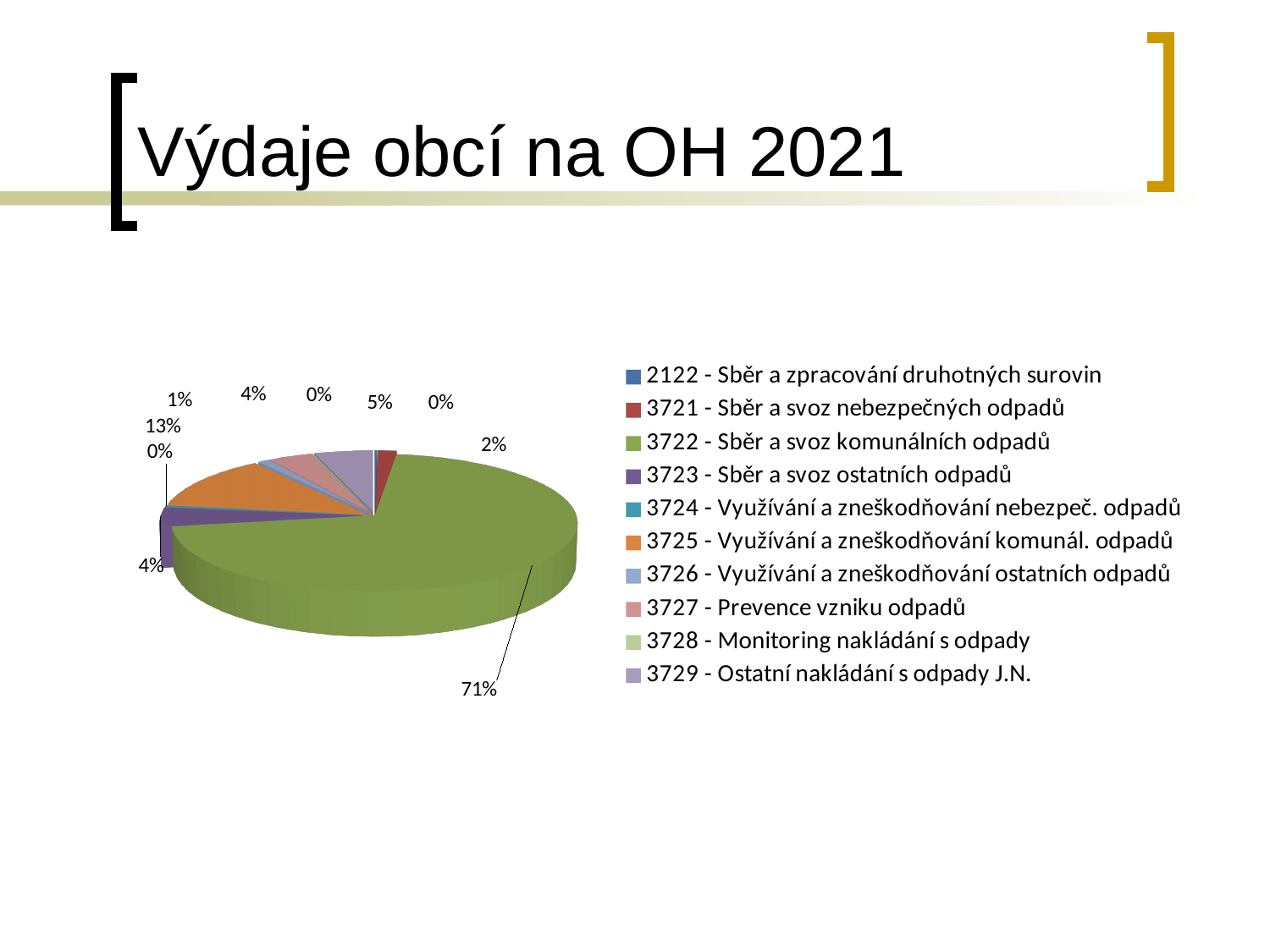
What share of the pie does 3729 - Ostatní nakládání s odpady J.N. have? 5% What share of the pie does 3725 - Využívání a zneškodňování komunál. odpadů have? 13% Which legend entry is shown in green, the colour of the largest slice? 3722 - Sběr a svoz komunálních odpadů What share of the pie does 3721 - Sběr a svoz nebezpečných odpadů have? 2% What is the difference in percentage points between the share for 3722 - Sběr a svoz komunálních odpadů and the share for 3725 - Využívání a zneškodňování komunál. odpadů? 58 What is the title of the slide containing the chart? Výdaje obcí na OH 2021 Which is larger: the share for 3722 - Sběr a svoz komunálních odpadů or for 3725 - Využívání a zneškodňování komunál. odpadů? 3722 - Sběr a svoz komunálních odpadů Which category has the largest share of the pie? 3722 - Sběr a svoz komunálních odpadů What kind of chart is shown on the slide? pie chart How many categories does the legend of the pie chart list? 10